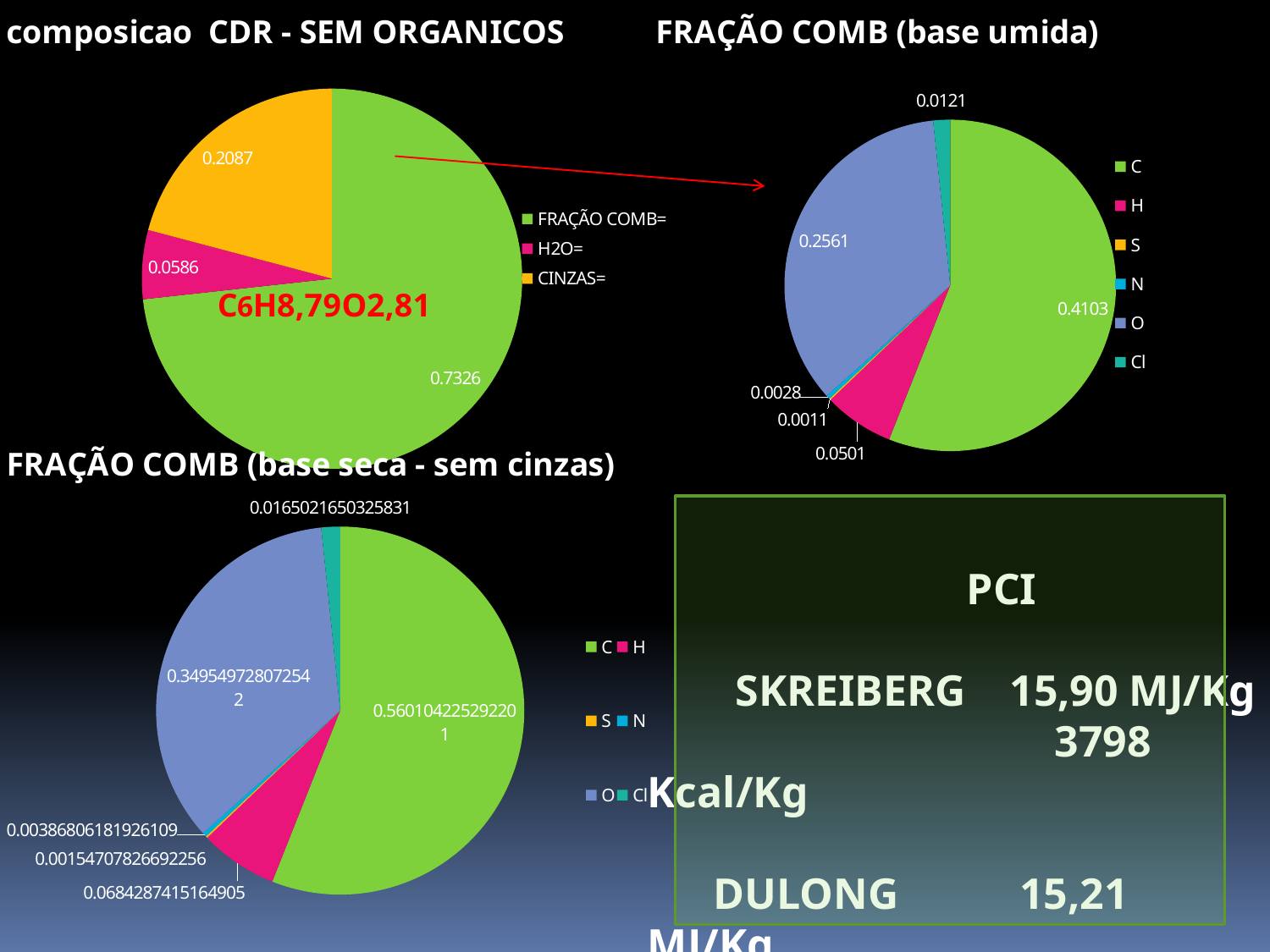
In the 'FRAÇÃO COMB (base umida)' chart, what is the value for C? 0.4103 In the 'FRAÇÃO COMB (base umida)' chart, which is larger, the value for H or the value for Cl? H How many entries does the legend of the 'FRAÇÃO COMB (base umida)' chart list? 6 In the 'composicao CDR - SEM ORGANICOS' chart, what is the value for FRAÇÃO COMB=? 0.7326 In the 'composicao CDR - SEM ORGANICOS' chart, which category has the smallest slice? H2O= In the 'composicao CDR - SEM ORGANICOS' chart, what is the value for CINZAS=? 0.2087 In the 'FRAÇÃO COMB (base umida)' chart, which element has the largest slice? C How many categories does the legend of the 'composicao CDR - SEM ORGANICOS' chart list? 3 In the 'FRAÇÃO COMB (base seca - sem cinzas)' chart, what is the value for O? 0.349549728072542 What type of chart is the 'FRAÇÃO COMB (base seca - sem cinzas)' chart? Pie chart In the 'FRAÇÃO COMB (base umida)' chart, what is the value for O? 0.2561 In the 'composicao CDR - SEM ORGANICOS' chart, what is the difference between the FRAÇÃO COMB= and CINZAS= values? 0.5239